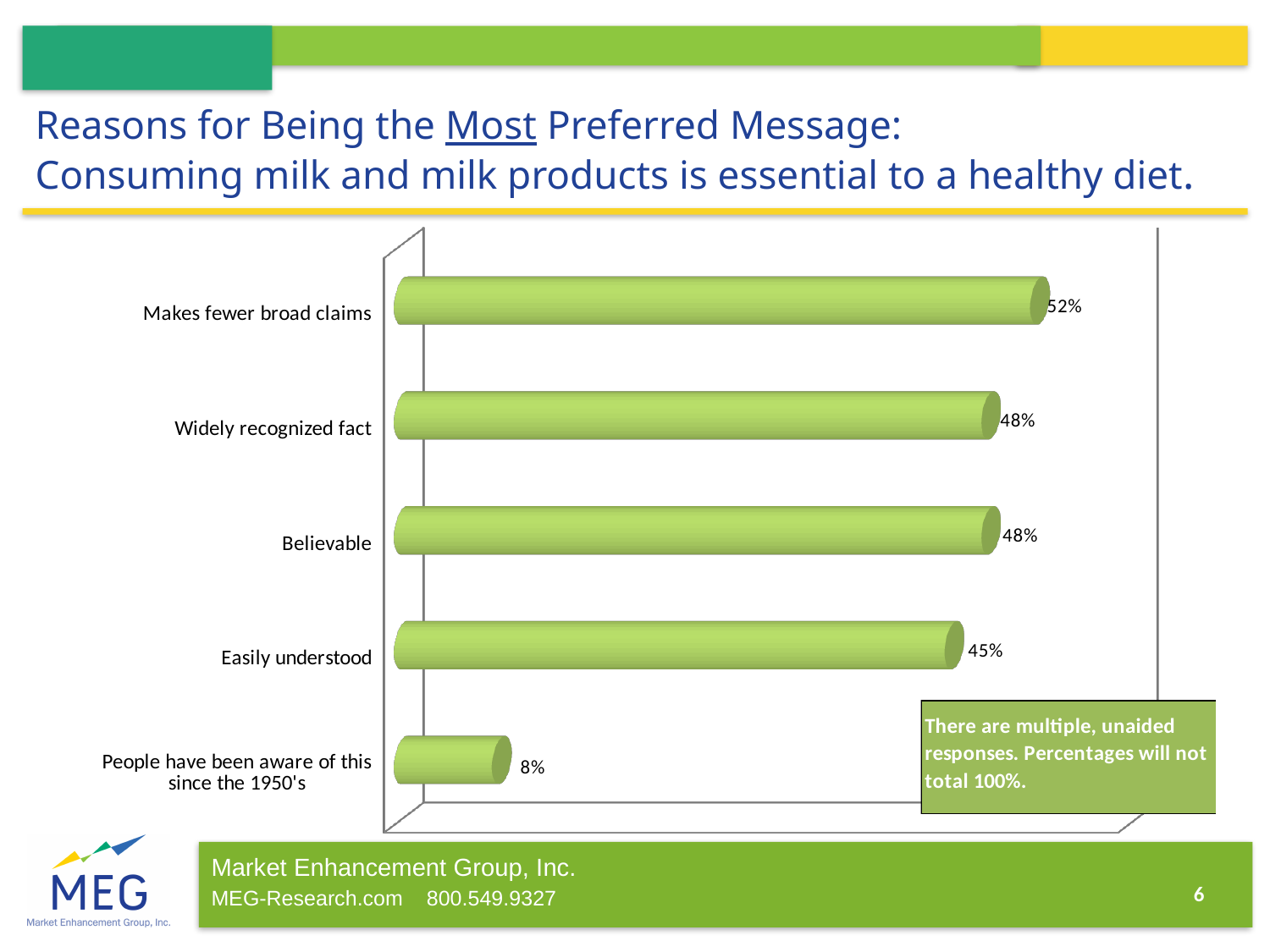
What kind of chart is shown on the slide? Bar chart What is the difference in percentage points between "Widely recognized fact" and "People have been aware of this since the 1950's"? 40 Which has a larger percentage, "Makes fewer broad claims" or "Easily understood"? Makes fewer broad claims What percentage is shown for "Makes fewer broad claims"? 52% How many reasons (categories) are shown in the chart? 5 What percentage is shown for "People have been aware of this since the 1950's"? 8% Which reason has the highest percentage? Makes fewer broad claims According to the note on the chart, why will the percentages not total 100%? There are multiple, unaided responses What is the difference in percentage points between "Makes fewer broad claims" and "Easily understood"? 7 What percentage is shown for "Believable"? 48% Which reason has the lowest percentage? People have been aware of this since the 1950's What percentage is shown for "Easily understood"? 45%